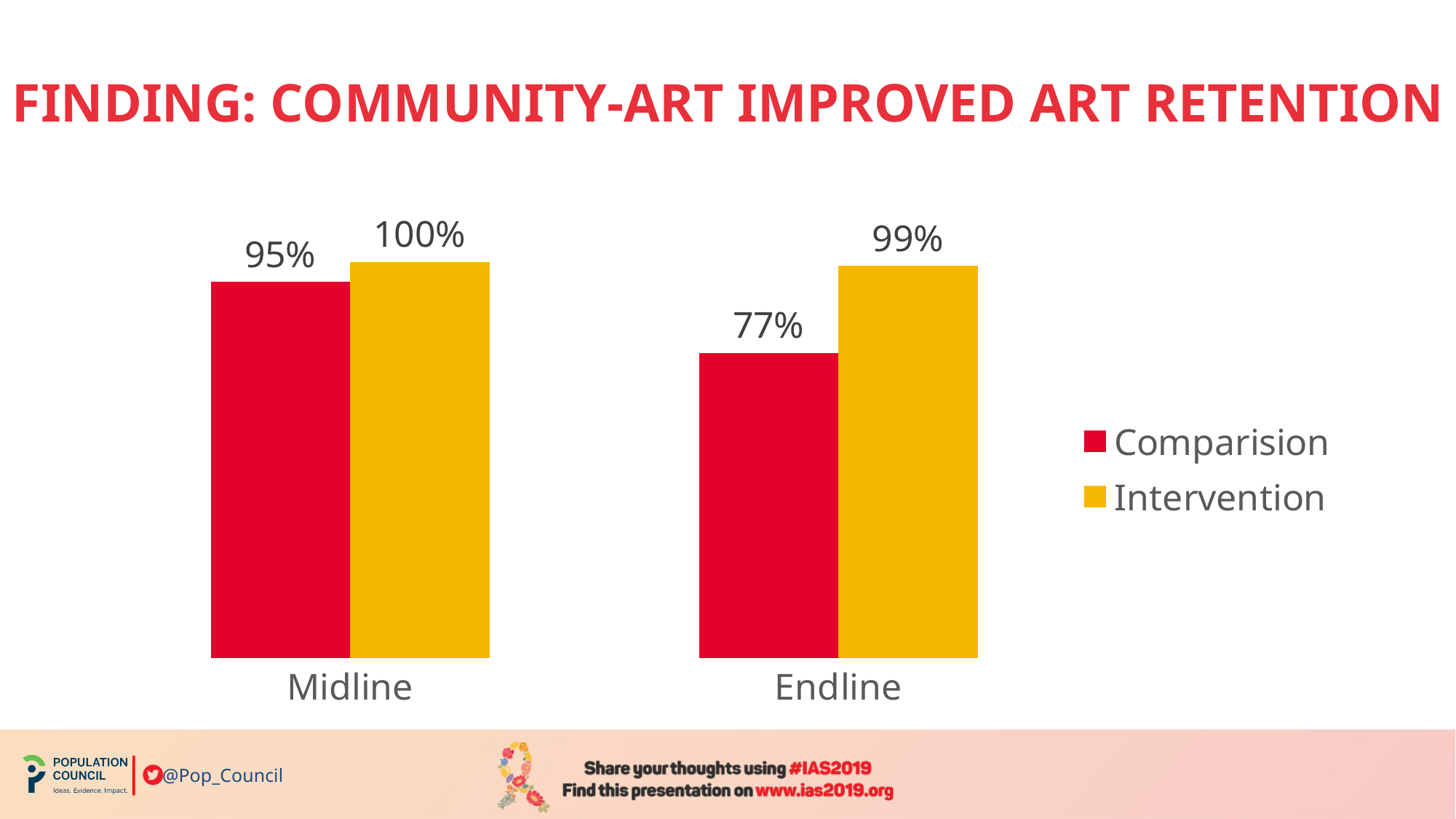
At Endline, which is larger: Comparision or Intervention? Intervention Which bar has the lowest value on the chart? Comparision at Endline What is the Intervention value at Midline? 100% What is the difference between the Comparision values at Midline and Endline? 18% What is the Comparision value at Endline? 77% What is the Intervention value at Endline? 99% How many series does the legend list? 2 What kind of chart is shown on the slide? Bar chart Which bar has the highest value on the chart? Intervention at Midline What is the Comparision value at Midline? 95% How many categories are shown on the x axis? 2 What is the difference between the Intervention and Comparision values at Endline? 22%